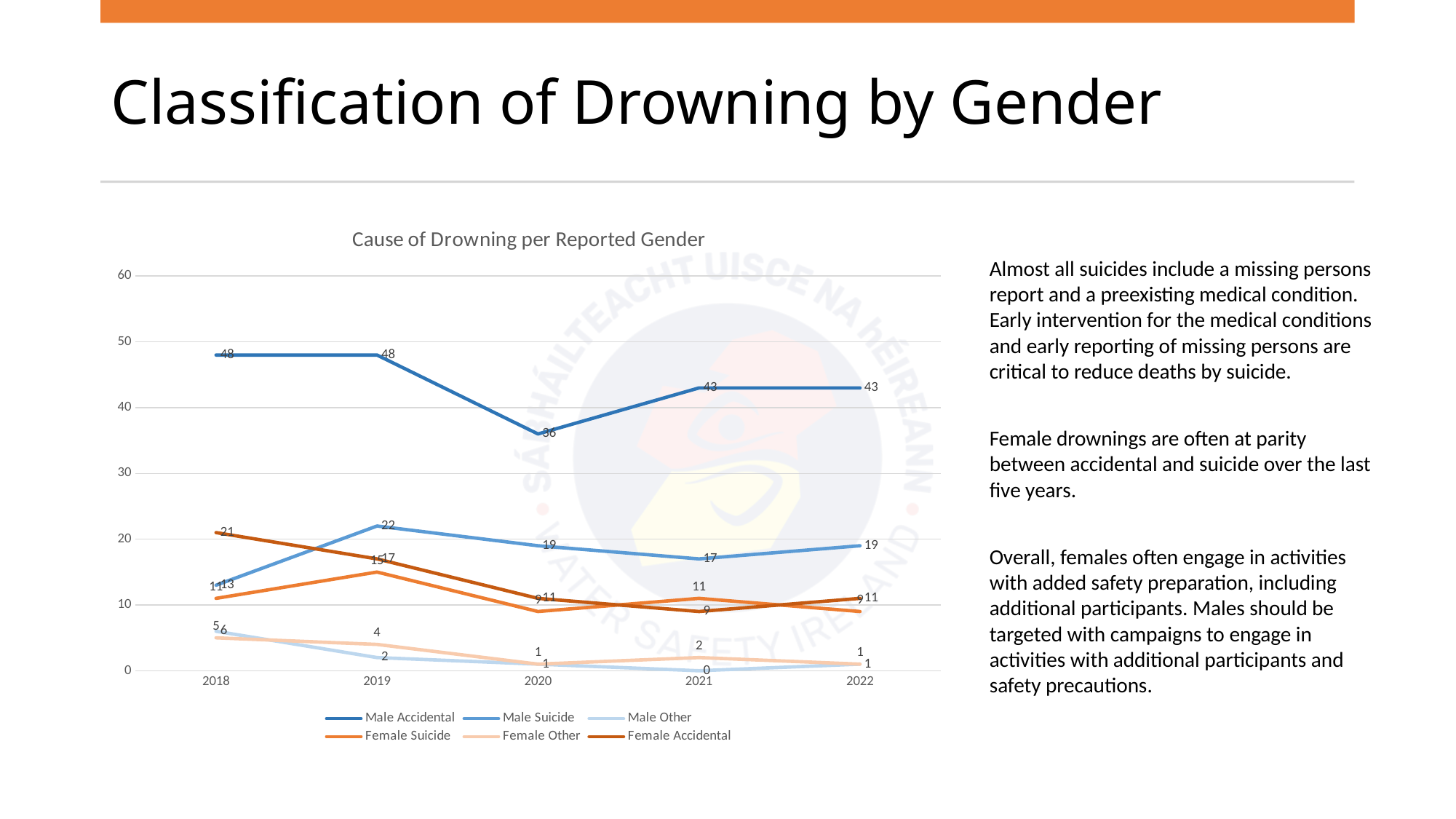
What is the value for Male Other in 2021? 0 What is the difference between the Male Accidental values for 2019 and 2020? 12 What is the value for Male Accidental in 2020? 36 How many series does the legend of the chart list? 6 In which year is the Male Accidental value lowest? 2020 What is the title of the chart? Cause of Drowning per Reported Gender Is the value for Male Accidental in 2021 greater or less than 40? greater How many years are plotted along the x axis of the chart? 5 What is the value for Female Accidental in 2018? 21 In 2021, which is larger: Male Accidental or Male Suicide? Male Accidental What kind of chart is shown on the slide? line chart What is the value for Male Suicide in 2019? 22